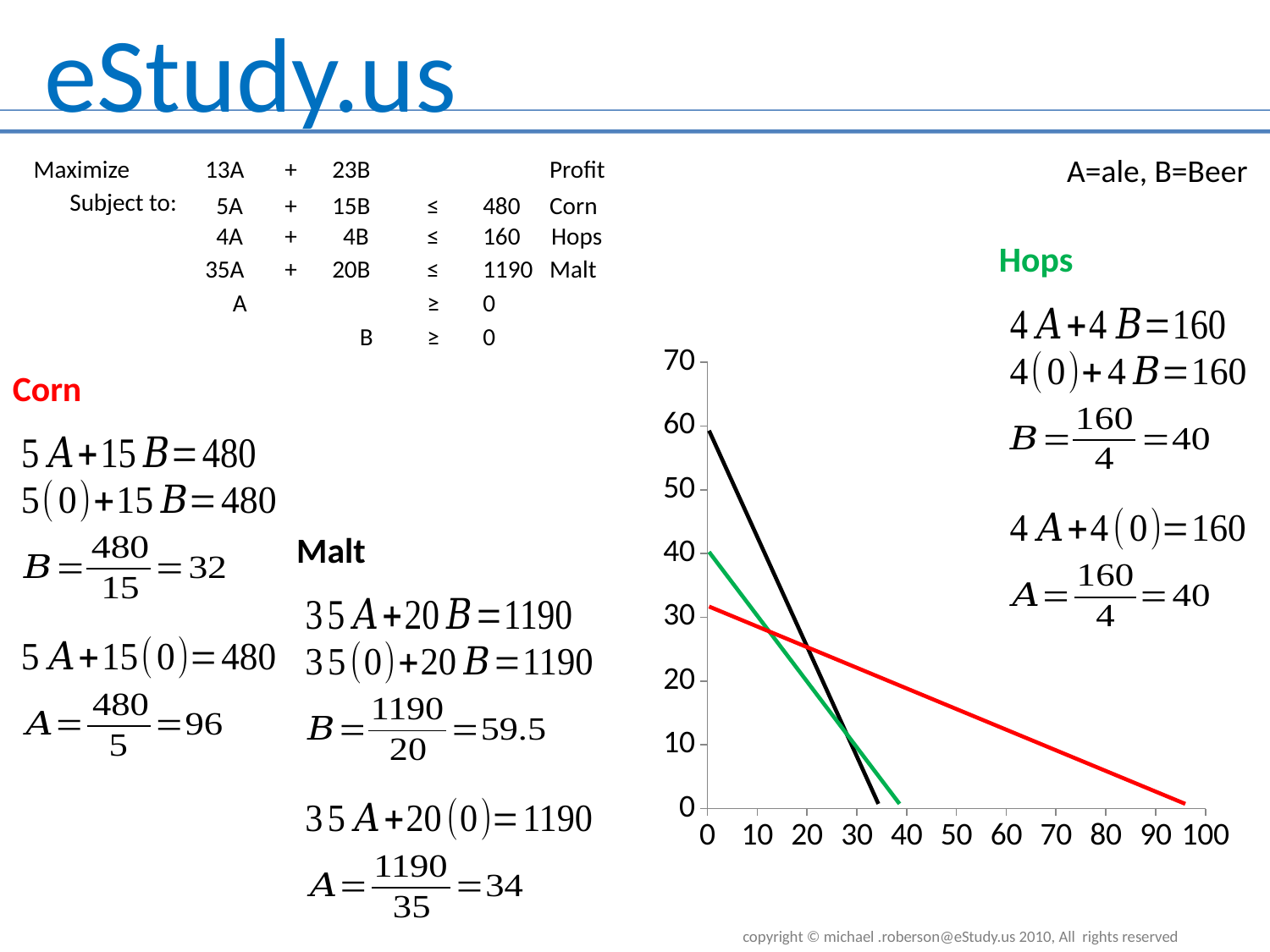
Do the plotted lines rise or fall as A increases along the horizontal axis? fall What kind of chart is shown on the slide? line chart Which constraint line has the smallest vertical-axis intercept? Corn (red) Which line has the larger vertical-axis intercept, the red line or the black line? black Is the horizontal-axis intercept of the red (Corn) line greater or less than 90? greater What colour is the Hops constraint line on the chart? green Is the vertical-axis intercept of the black (Malt) line greater or less than 50? greater At what value of A does the green (Hops) line meet the horizontal axis? 40 How many constraint lines are plotted on the chart? 3 What colour is the Corn constraint line on the chart? red At what value of B does the green (Hops) line meet the vertical axis? 40 Which constraint line extends farthest along the horizontal (A) axis? Corn (red)